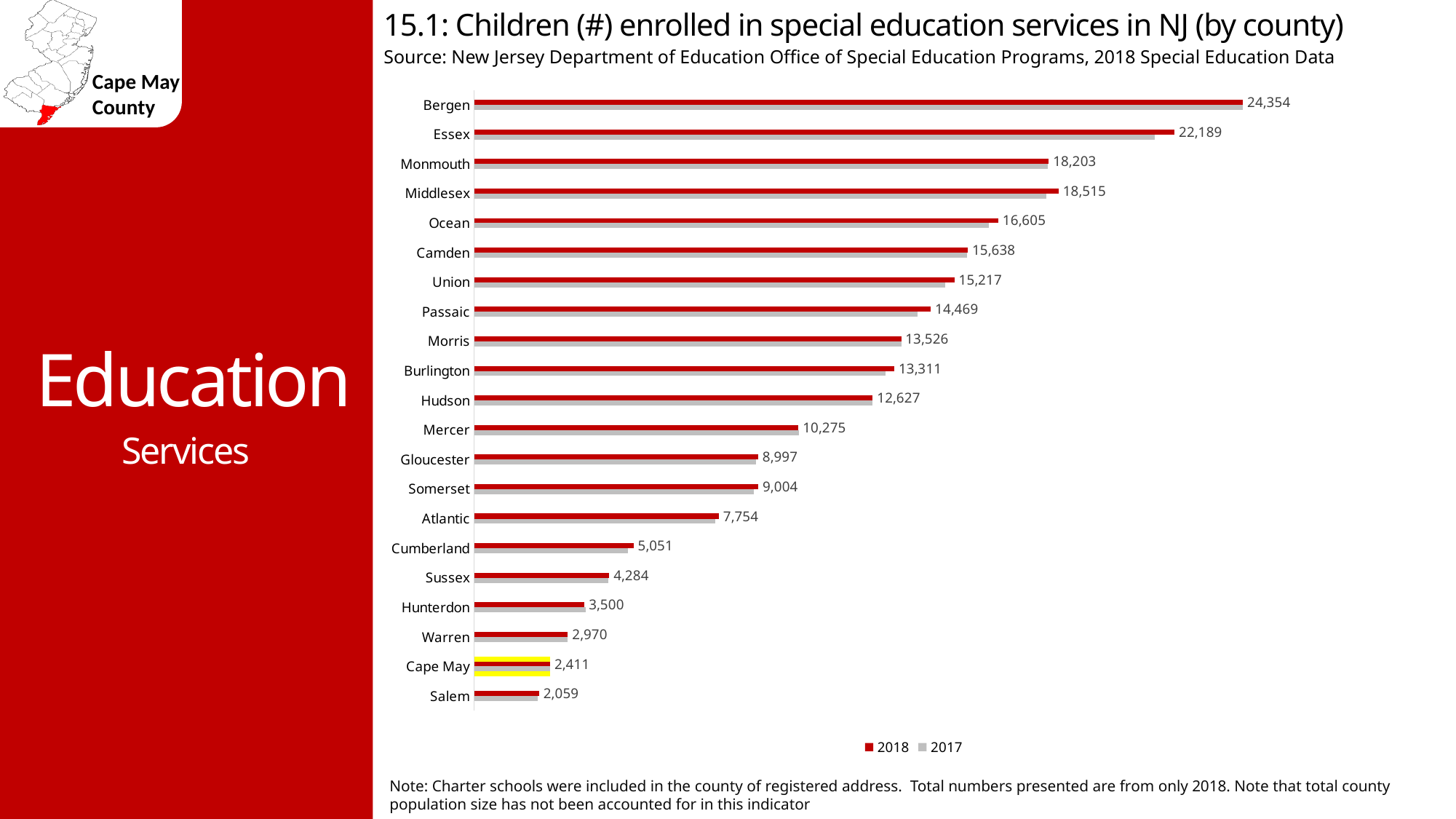
How many counties are shown in the chart? 21 What is the difference between the 2018 values for Cape May and Salem? 352 What is the difference between the 2018 values for Bergen and Essex? 2,165 Which county's bars are highlighted in yellow on the chart? Cape May What is the 2018 value for Bergen? 24,354 Which county has the highest 2018 value? Bergen How many series does the legend list? 2 Which has a larger 2018 value, Gloucester or Somerset? Somerset Which county has the lowest 2018 value? Salem What is the 2018 value for Cumberland? 5,051 What kind of chart is shown on the slide? bar chart What is the 2018 value for Cape May? 2,411